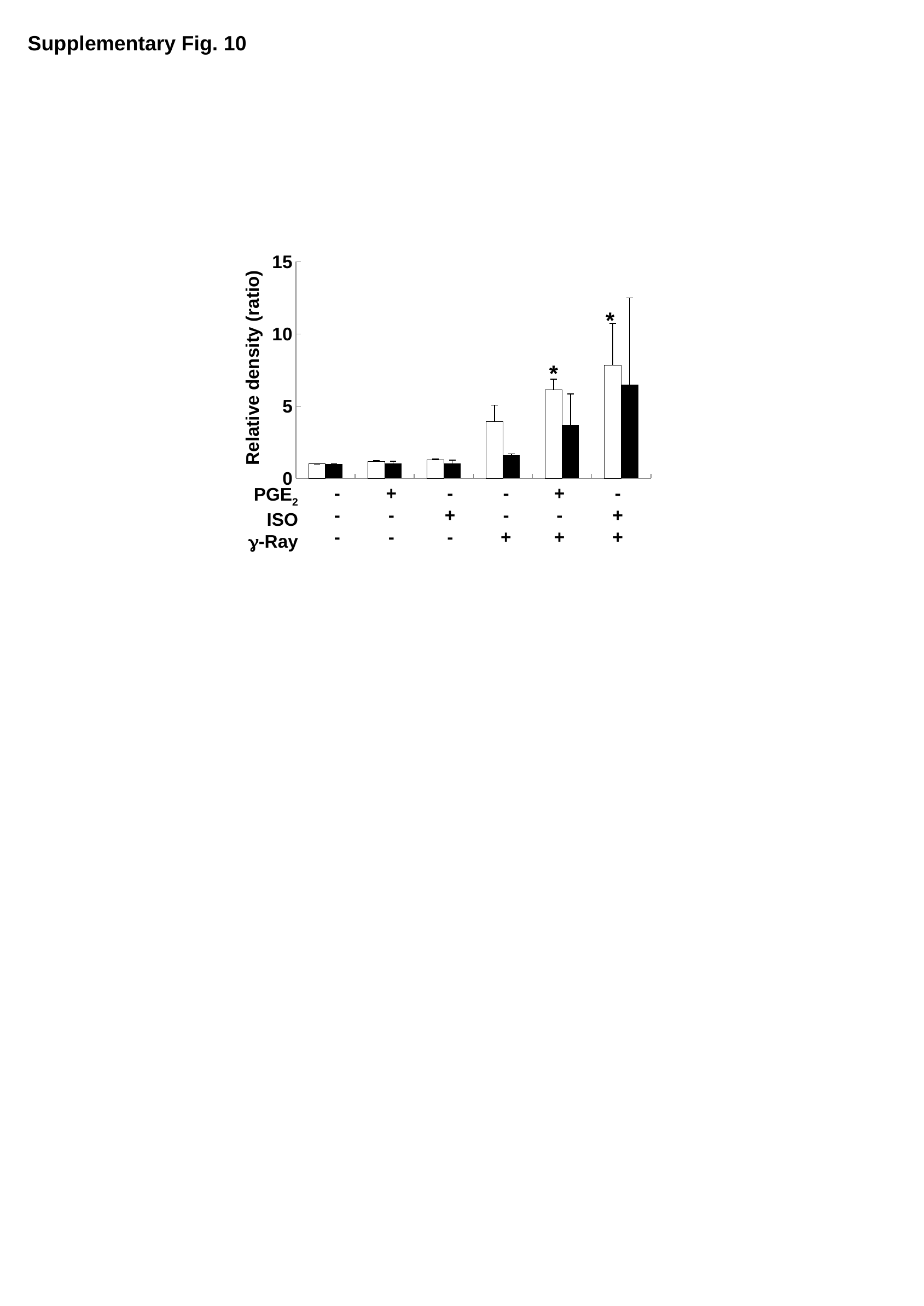
Which condition has the tallest white bar? ISO + and γ-Ray + (PGE2 -) What is the title of the y axis? Relative density (ratio) Is the white bar for the condition with ISO + and γ-Ray + greater or less than 10? less How many conditions are marked with an asterisk above the white bar? 2 How many treatment conditions (groups of bars) are shown along the x axis? 6 Is the white bar for the condition with ISO + and γ-Ray + greater or less than 5? greater Is the black bar for the condition with only γ-Ray + (PGE2 -, ISO -) greater or less than 5? less Which is taller: the white bar for the γ-Ray-only condition or the white bar for the ISO + γ-Ray condition? ISO + γ-Ray condition What kind of chart is shown on the slide? bar chart For the condition with PGE2 + and γ-Ray +, which bar is taller, the white bar or the black bar? white bar